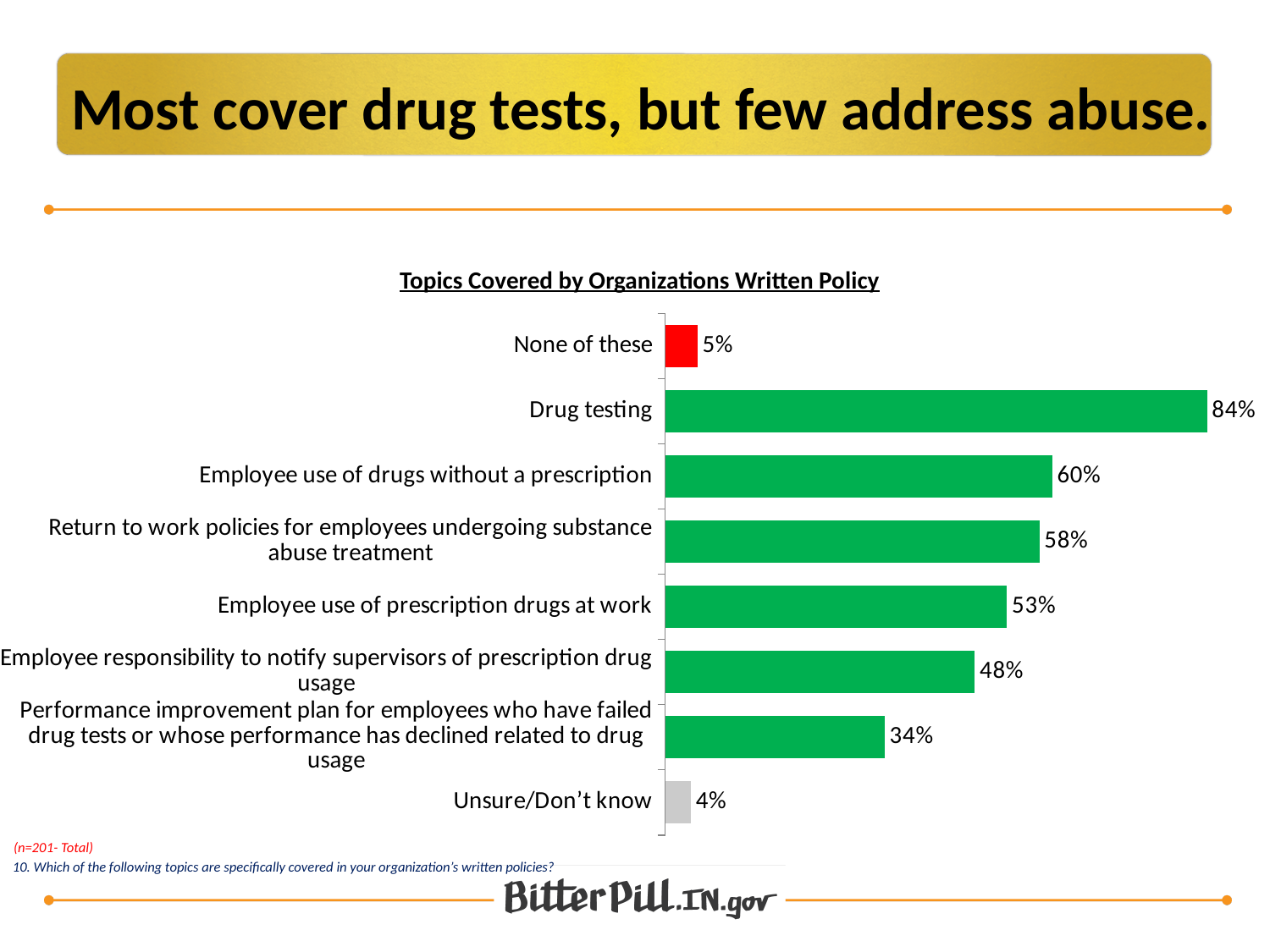
What is the value for 'Unsure/Don't know'? 4% What colour is the bar for 'None of these'? Red What is the value for 'Employee use of prescription drugs at work'? 53% Which category has the lowest percentage? Unsure/Don't know How many categories are shown in the chart? 8 What is the difference between the value for 'Drug testing' and the value for 'Employee use of drugs without a prescription'? 24% What type of chart is shown on the slide? Bar chart What is the value for 'Performance improvement plan for employees who have failed drug tests or whose performance has declined related to drug usage'? 34% Which is larger: the value for 'Return to work policies for employees undergoing substance abuse treatment' or the value for 'Employee responsibility to notify supervisors of prescription drug usage'? Return to work policies for employees undergoing substance abuse treatment What percentage of organizations' written policies cover drug testing? 84% Which topic has the highest percentage? Drug testing What is the title of the chart? Topics Covered by Organizations Written Policy